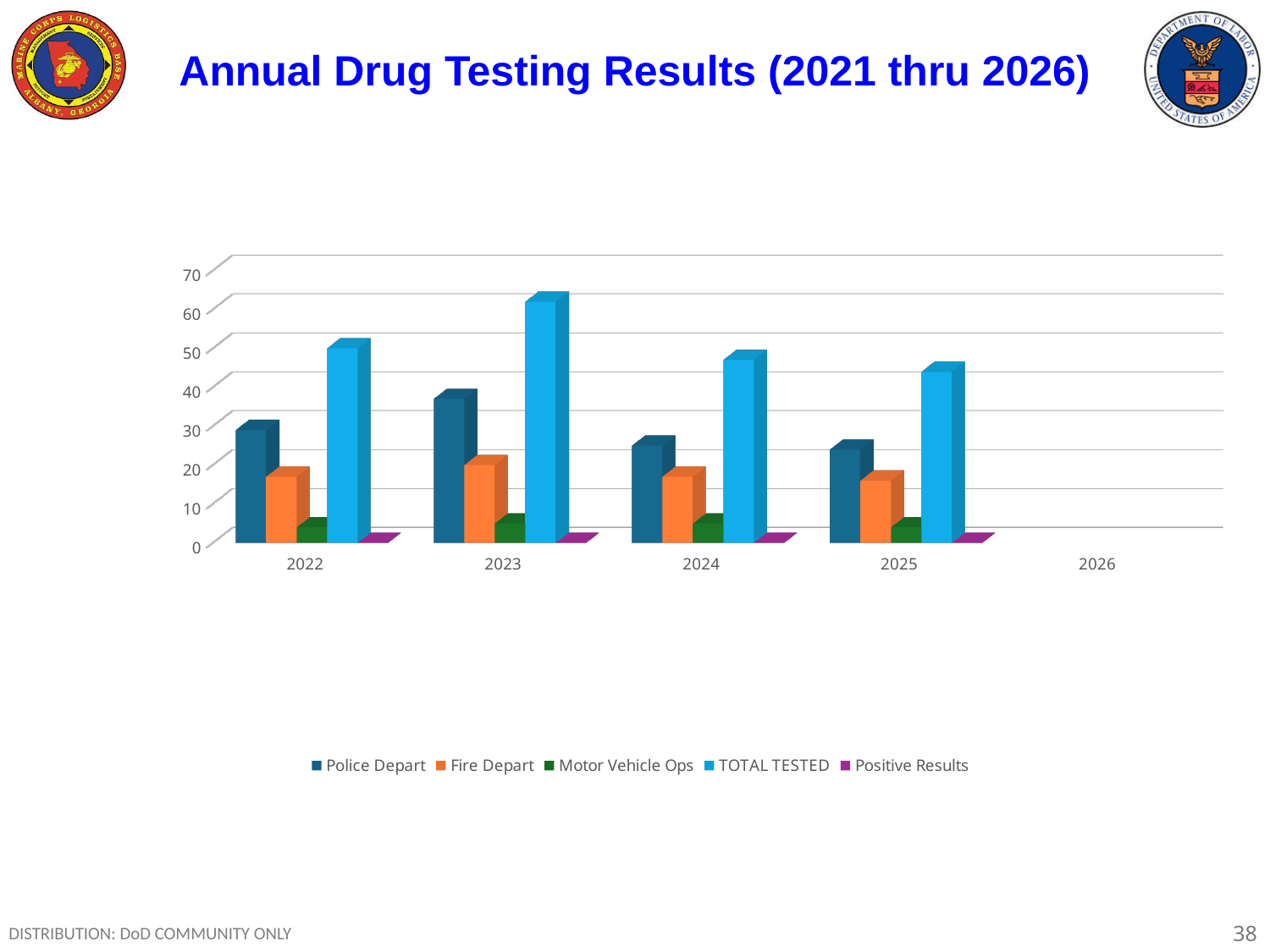
How many series does the legend list? 5 In which year is the TOTAL TESTED bar the highest? 2023 Is the Motor Vehicle Ops value for 2023 greater or less than 10? less What is the title of the slide containing the chart? Annual Drug Testing Results (2021 thru 2026) Does the TOTAL TESTED value rise or fall from 2023 to 2025? fall Is the Police Depart value for 2023 greater or less than 30? greater What kind of chart is shown on the slide? bar chart Which series has the lowest bar in 2022? Positive Results Is the TOTAL TESTED value for 2023 greater or less than 50? greater Which series has the tallest bar in 2023? TOTAL TESTED How many years are labelled on the x axis? 5 Which is larger, the Police Depart value for 2022 or for 2023? 2023